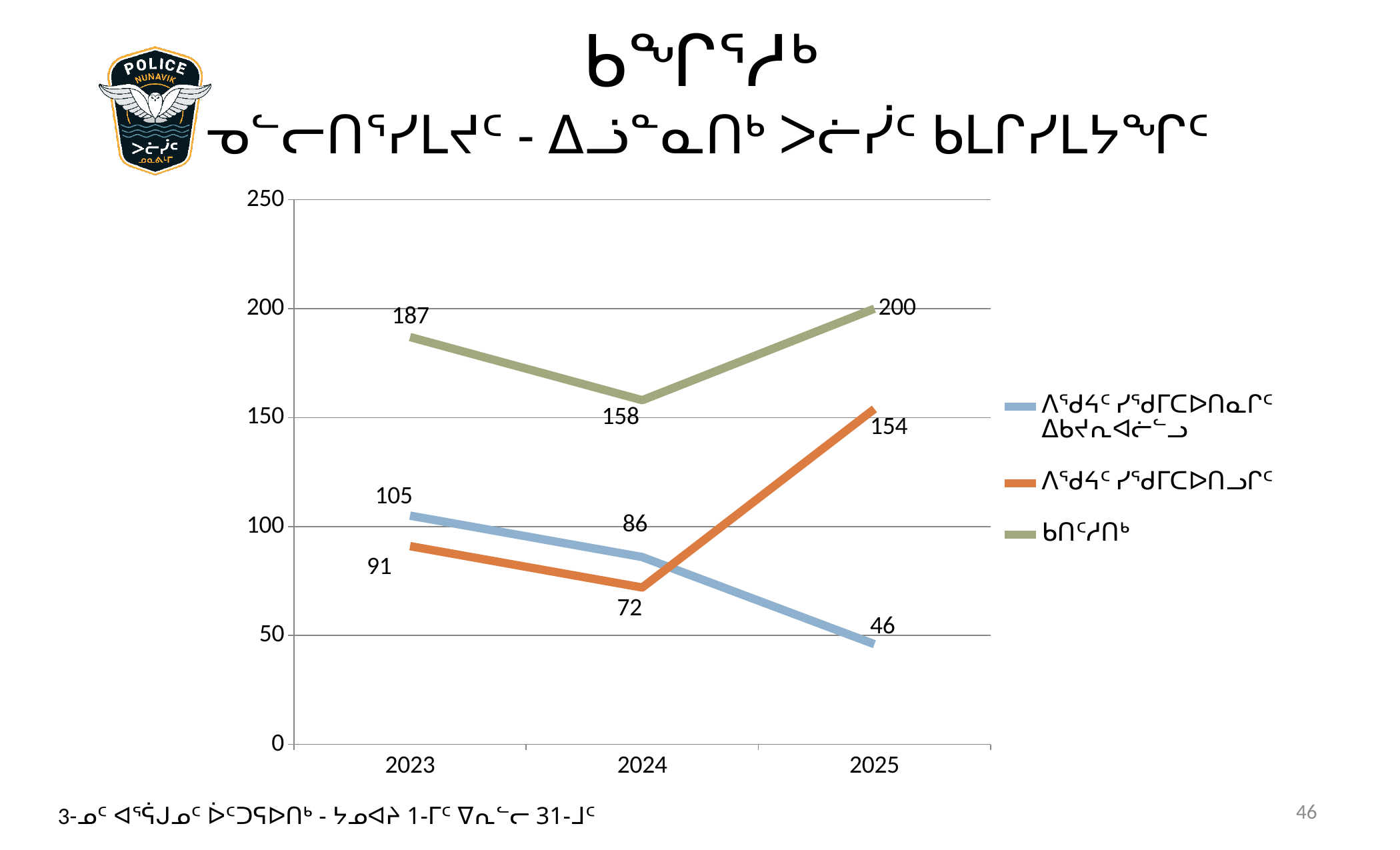
How many series does the legend list? 3 Does the blue line rise or fall from 2023 to 2025? fall How many years are shown on the x axis? 3 What is the value of the orange line in 2024? 72 Which is larger in 2025, the orange line or the blue line? the orange line What is the value of the blue line in 2025? 46 What is the value of the green line in 2023? 187 What is the difference between the orange line's values in 2025 and 2023? 63 What is the difference between the green line's values in 2025 and 2024? 42 In which year does the blue line have its lowest value? 2025 What type of chart is shown on the slide? line chart In which year does the green line reach its highest value? 2025